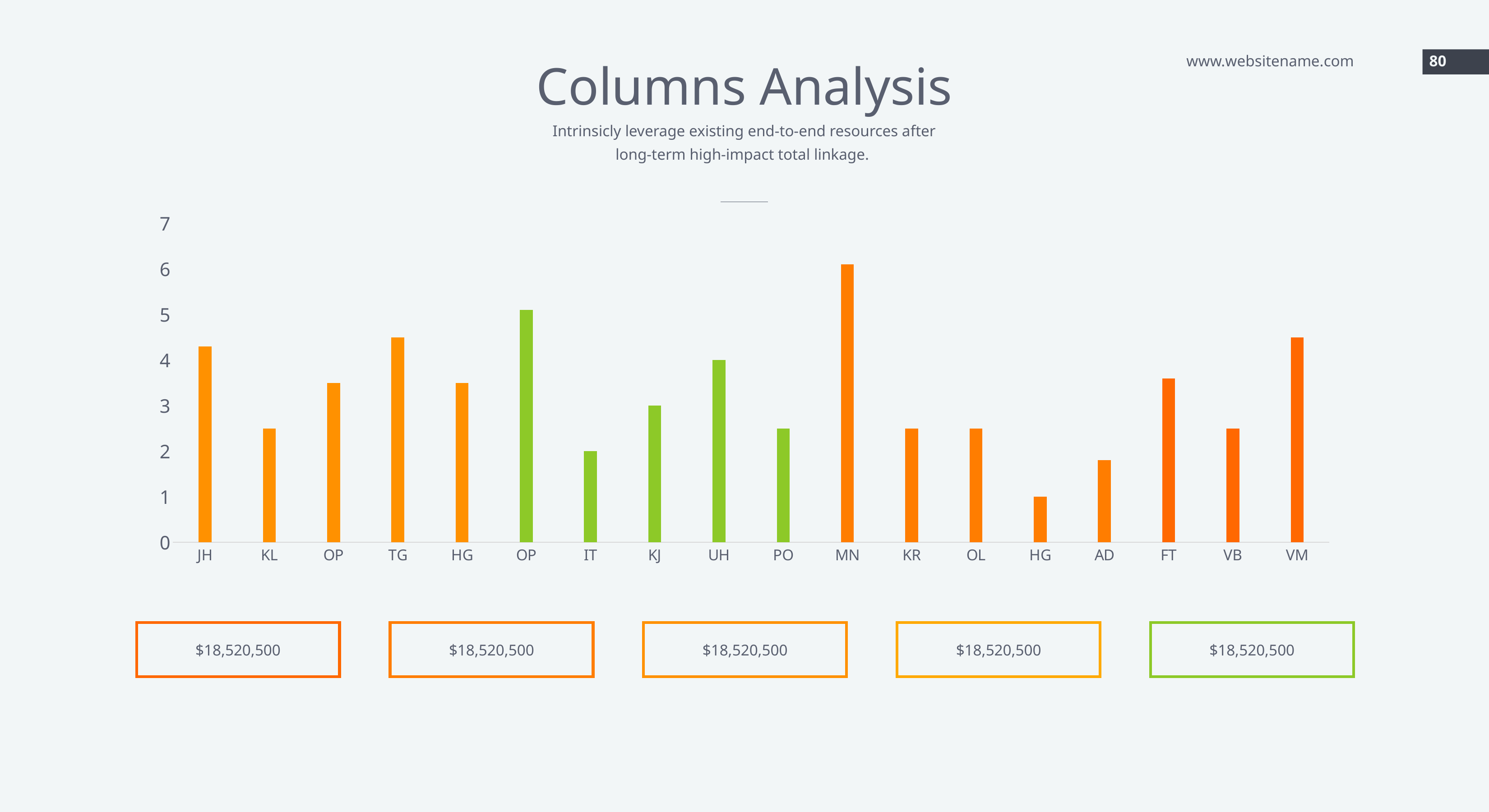
Is the value for MN greater or less than 5? greater What is the title of the chart on the slide? Columns Analysis Is the value for IT greater or less than 3? less How many categories are plotted along the x axis of the chart? 18 Which is larger, the value for IT or the value for UH? UH Which is larger, the value for JH or the value for KL? JH What kind of chart is shown on the slide? bar chart Which category has the lowest bar in the chart? HG Is the value for VM greater or less than 4? greater Which is larger, the value for MN or the value for VM? MN Which category has the highest bar in the chart? MN